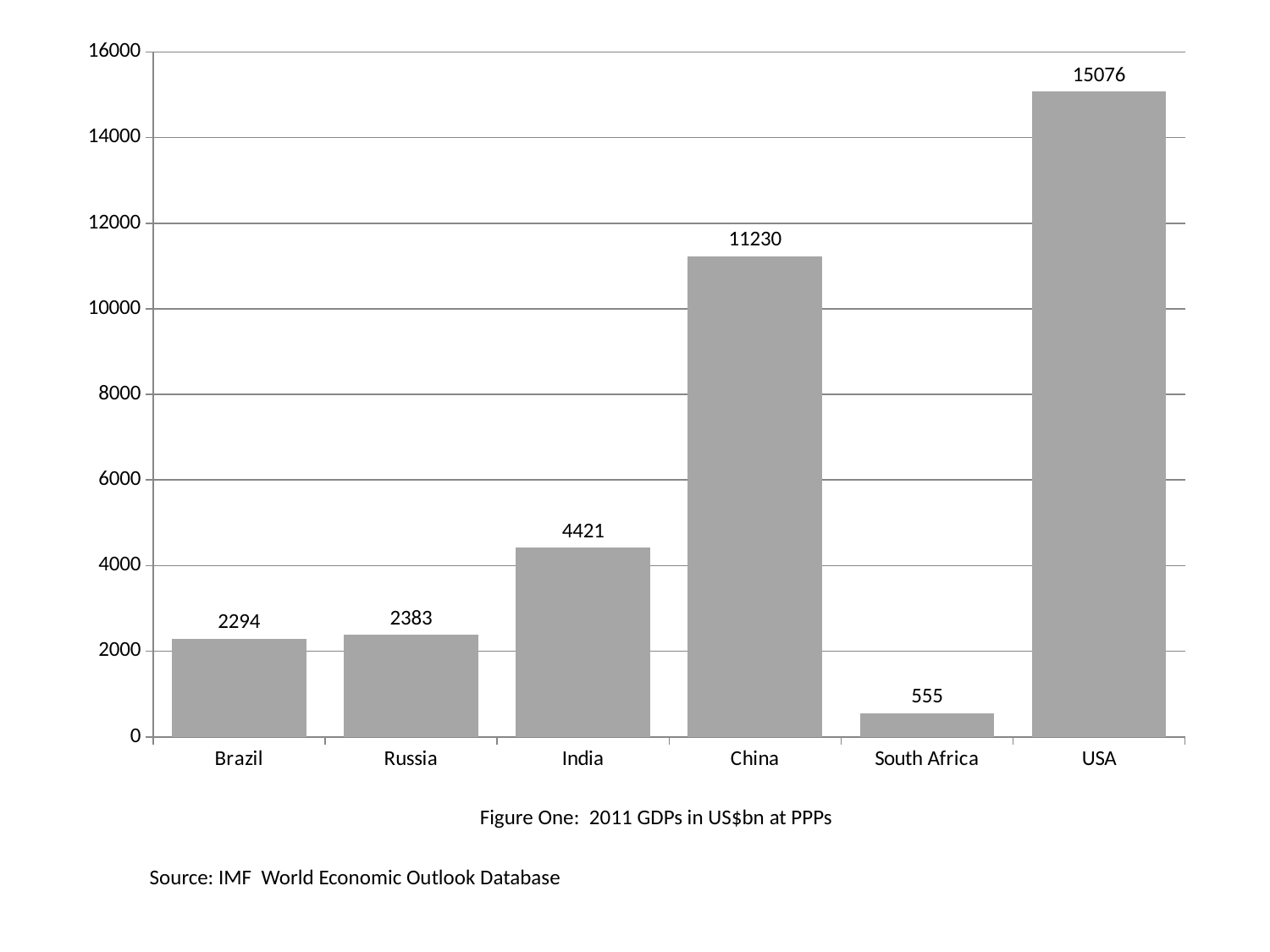
Is the value for China greater or less than 10000? greater Which is larger, the value for India or the value for Russia? India Which country has the lowest GDP in the chart? South Africa What is the 2011 GDP value shown for China? 11230 What is the caption of the figure? Figure One: 2011 GDPs in US$bn at PPPs What kind of chart is shown on the slide? bar chart What is the value shown for India? 4421 Which country has the highest GDP in the chart? USA What is the value shown for South Africa? 555 How many countries are shown in the chart? 6 What is the difference between the values for USA and China? 3846 What is the difference between the values for Russia and Brazil? 89